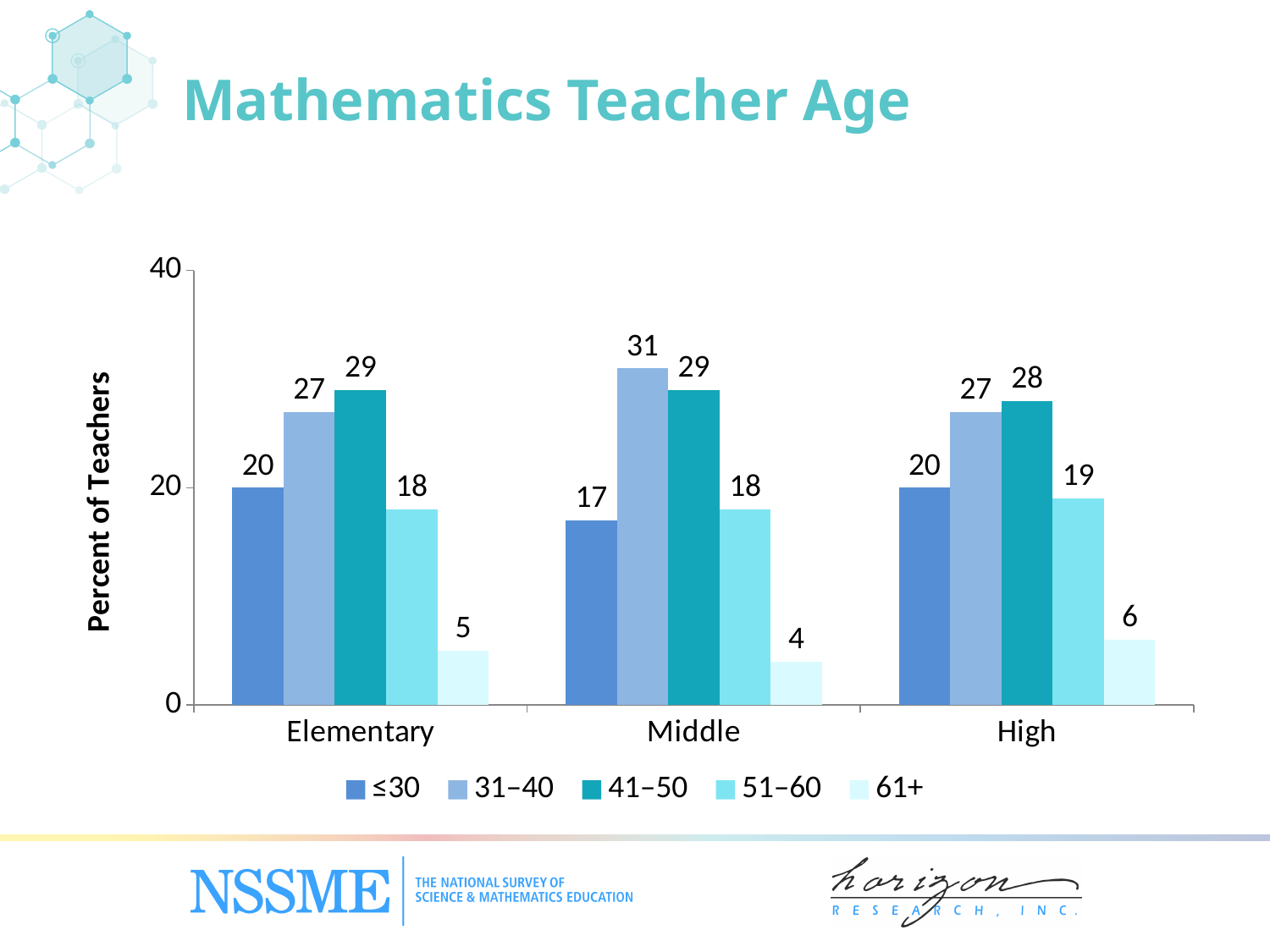
What is the title of the chart? Mathematics Teacher Age How many school levels are shown on the x axis? 3 How many age groups does the legend list? 5 What is the difference between the percentage of middle school teachers aged 31–40 and those aged ≤30? 14 What percent of middle school mathematics teachers are aged 31–40? 31 Which age group has the highest percentage of middle school mathematics teachers? 31–40 Which age group has the lowest percentage of elementary mathematics teachers? 61+ What percent of elementary mathematics teachers are aged 51–60? 18 What is the label of the y axis? Percent of Teachers Which is larger: the percentage of elementary teachers aged ≤30 or the percentage of middle school teachers aged ≤30? Elementary What kind of chart is shown on the slide? Bar chart What percent of high school mathematics teachers are aged 61+? 6